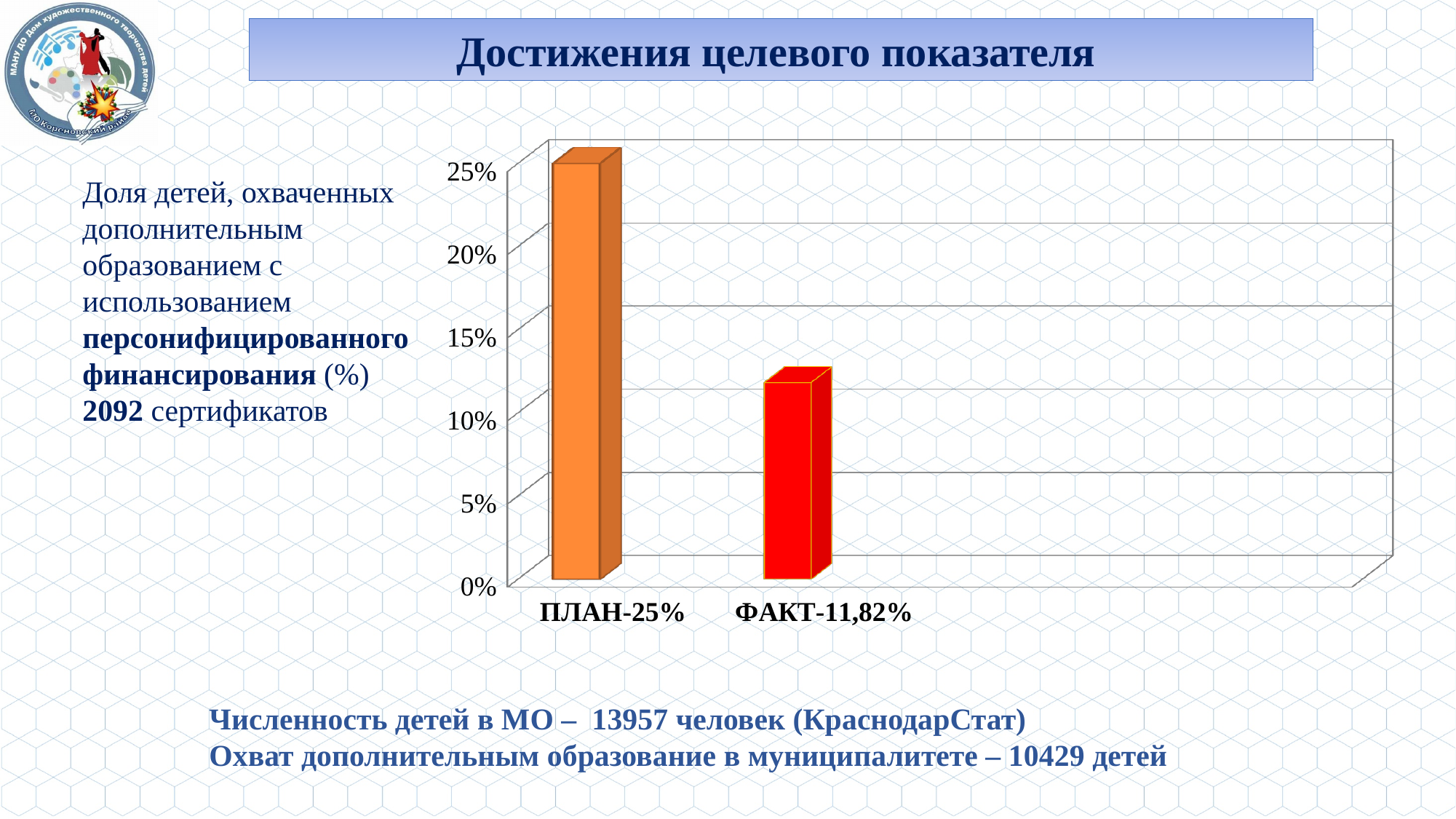
What type of chart is shown on the slide? bar chart How many bars are plotted in the chart? 2 Is the value for ФАКТ greater or less than 15%? less Is the value for ПЛАН greater or less than 20%? greater What is the value for ПЛАН? 25% What is the value for ФАКТ? 11,82% What is the highest tick label on the vertical axis? 25% Which category has the lowest value? ФАКТ Which is larger, the value for ПЛАН or the value for ФАКТ? ПЛАН Which category has the highest value? ПЛАН What colour is the ФАКТ bar? red What is the difference between the ПЛАН value and the ФАКТ value? 13,18%